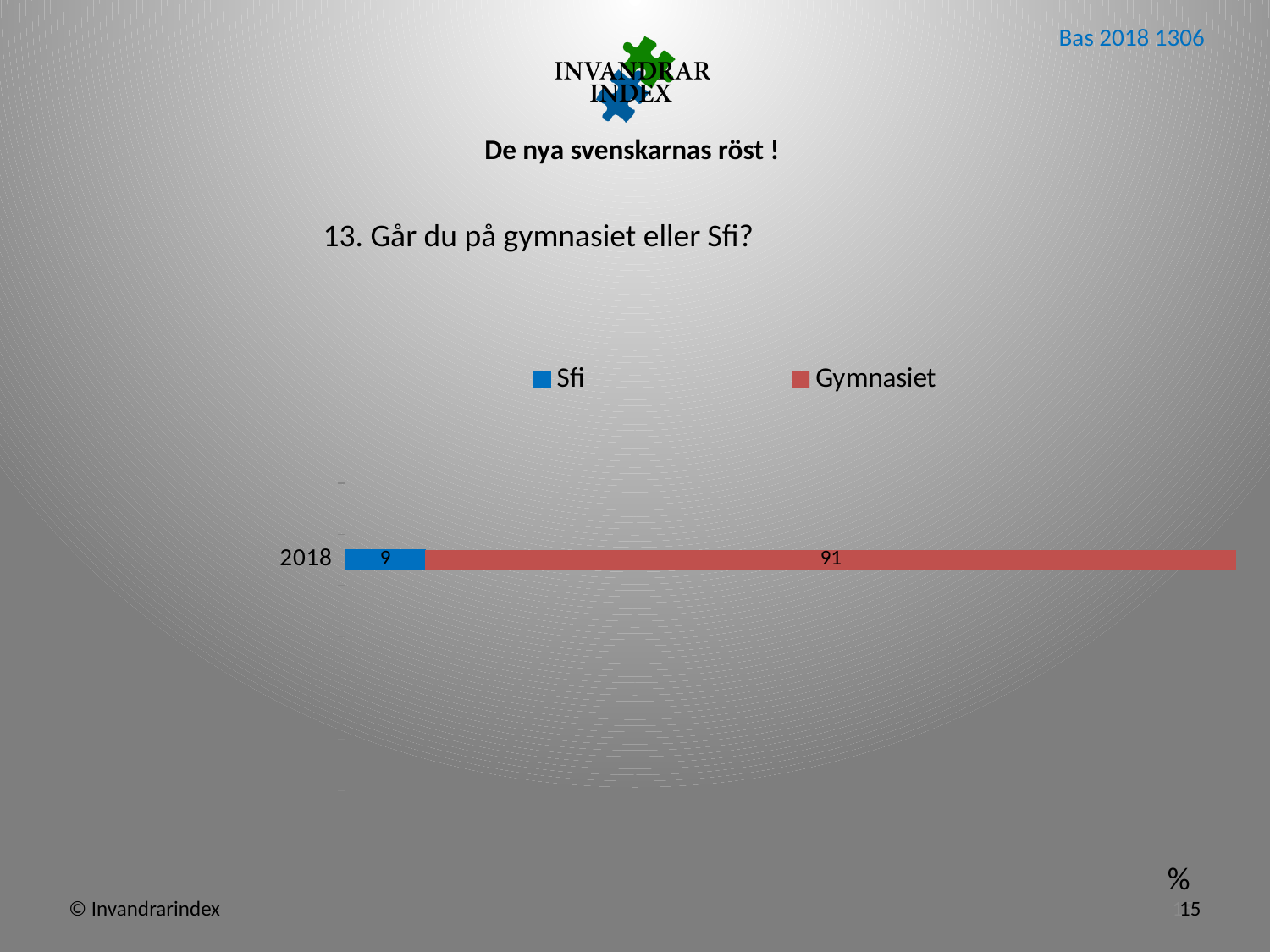
What is the total of the stacked bar for 2018? 100 What is the value for Gymnasiet in 2018? 91 How many categories are shown on the chart? 1 Which category label is shown on the chart's axis? 2018 What is the value for Sfi in 2018? 9 What is the difference between the Gymnasiet and Sfi values in 2018? 82 What colour represents Gymnasiet in the chart? Red How many series does the legend list? 2 What kind of chart is shown on the slide? Stacked bar chart Which series has the higher value in 2018, Sfi or Gymnasiet? Gymnasiet